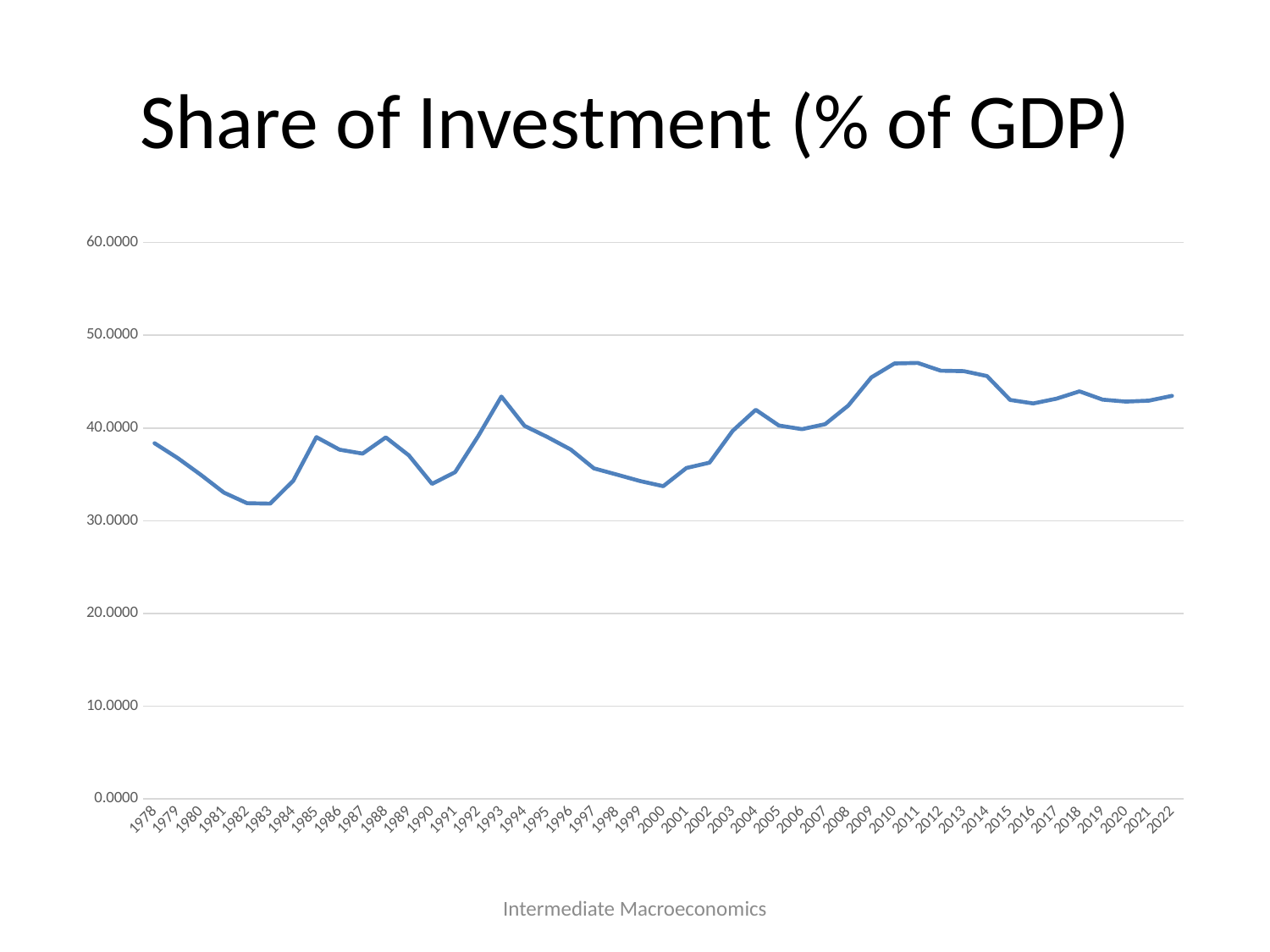
Do the values rise or fall from 2000 to 2011? rise Is the value for 1982 greater or less than 40? less Is the value for 1978 greater or less than 30? greater Which year has the larger value, 1985 or 1990? 1985 Is the value for 2022 greater or less than 40? greater Which year has the larger value, 1993 or 2000? 1993 How many years are plotted along the x axis? 45 What kind of chart is shown on the slide? line chart What is the title of the chart? Share of Investment (% of GDP)